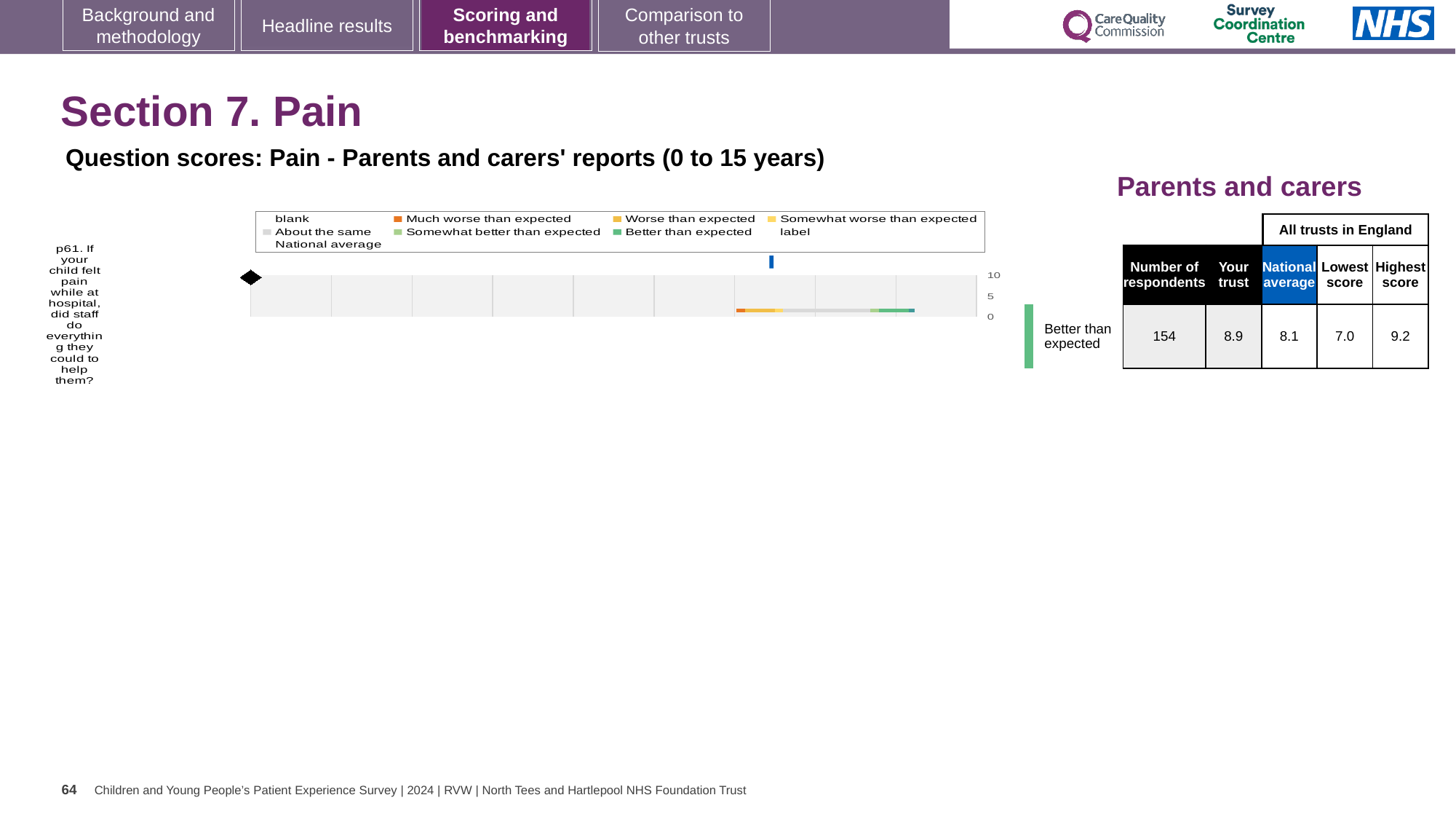
What is the Highest score among all trusts in England for question p61? 9.2 By how much does the Your trust score exceed the National average for question p61? 0.8 Which is larger for question p61: the Your trust score or the National average? Your trust What is the Lowest score among all trusts in England for question p61? 7.0 What is the difference between the Highest score and the Lowest score for question p61? 2.2 What is the 'Your trust' score for question p61? 8.9 What kind of chart is shown on the slide for question p61? bar chart How many respondents are shown for question p61 in the Parents and carers table? 154 What benchmark category is the trust's score for p61 placed in, according to the label beside the table? Better than expected What is the National average score for question p61? 8.1 In the chart legend, which category is shown in orange? Much worse than expected Which survey question is plotted in the chart on this slide? p61. If your child felt pain while at hospital, did staff do everything they could to help them?